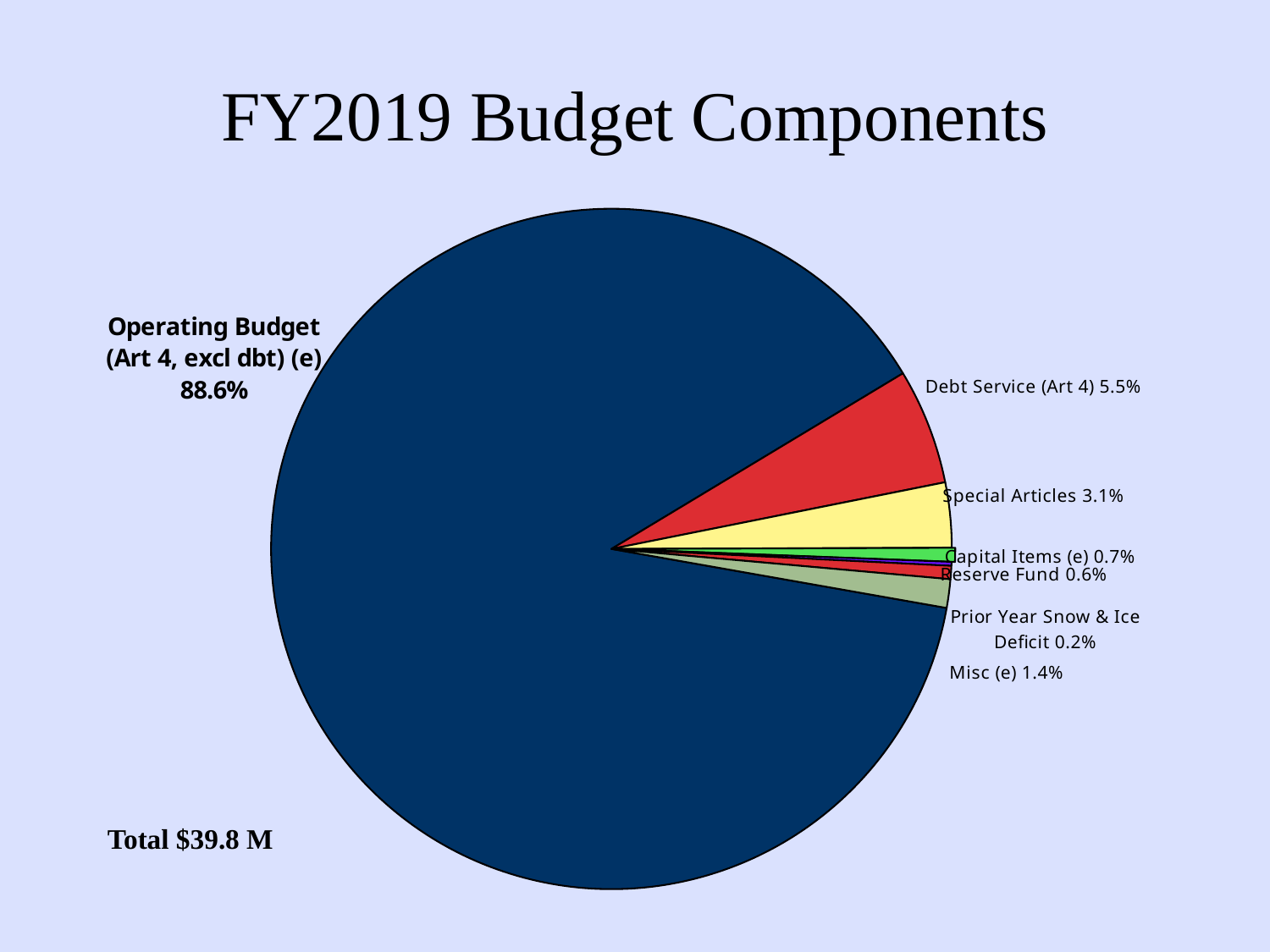
What percentage is shown for Reserve Fund? 0.6% Which component has the largest share of the pie? Operating Budget (Art 4, excl dbt) (e) What percentage is shown for Misc (e)? 1.4% What percentage is shown for Operating Budget (Art 4, excl dbt) (e)? 88.6% What total amount is stated on the slide for the budget? $39.8 M Which component has the smallest share of the pie? Prior Year Snow & Ice Deficit Which is larger, Capital Items (e) or Reserve Fund? Capital Items (e) How many slices does the pie chart have? 7 What type of chart is shown on the slide? Pie chart What share of the pie does Debt Service (Art 4) represent? 5.5% What is the difference in percentage points between Debt Service (Art 4) and Special Articles? 2.4 What share of the pie does Special Articles represent? 3.1%